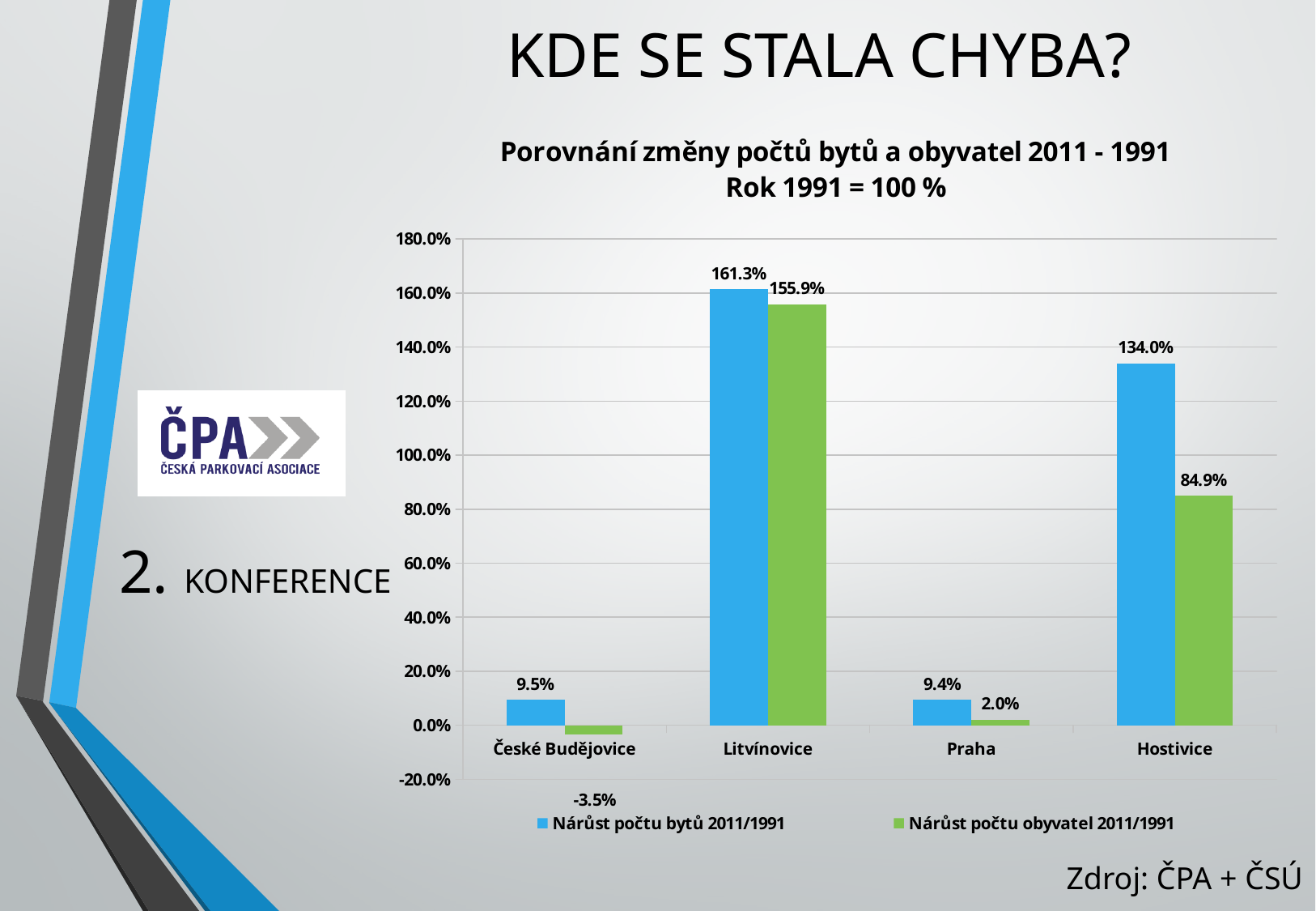
How many series does the legend list? 2 What is the value of Nárůst počtu obyvatel 2011/1991 for Hostivice? 84.9% How many categories are shown on the x axis? 4 What is the value of Nárůst počtu obyvatel 2011/1991 for České Budějovice? -3.5% Which category has the highest value for Nárůst počtu bytů 2011/1991? Litvínovice Which category has the lowest value for Nárůst počtu obyvatel 2011/1991? České Budějovice Which is larger for Litvínovice: Nárůst počtu bytů 2011/1991 or Nárůst počtu obyvatel 2011/1991? Nárůst počtu bytů 2011/1991 What kind of chart is shown on the slide? Bar chart What is the value of Nárůst počtu bytů 2011/1991 for Praha? 9.4% What is the value of Nárůst počtu bytů 2011/1991 for Litvínovice? 161.3% What is the difference between Nárůst počtu bytů 2011/1991 and Nárůst počtu obyvatel 2011/1991 for Hostivice? 49.1% What is the title of the chart? Porovnání změny počtů bytů a obyvatel 2011 - 1991 Rok 1991 = 100 %